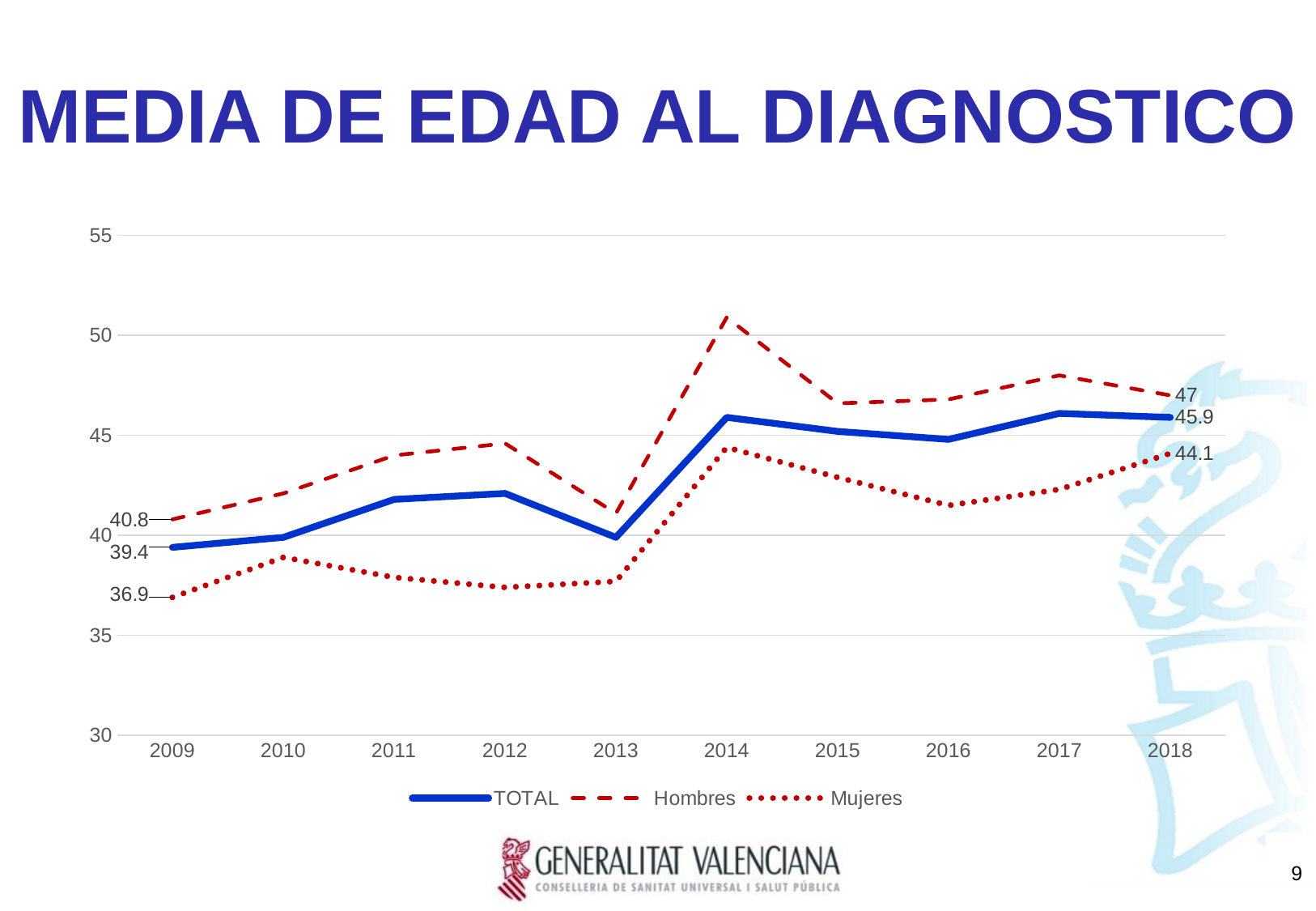
Which series has the higher value in 2009, TOTAL or Mujeres? TOTAL In which year does the Hombres series reach its highest value? 2014 What is the difference between the Hombres and Mujeres values in 2018? 2.9 What is the value for TOTAL in 2018? 45.9 What kind of chart is shown on the slide? Line chart What is the value for Mujeres in 2018? 44.1 Is the value for Hombres in 2014 greater or less than 50? greater What is the value for Hombres in 2009? 40.8 What is the difference between the Hombres value in 2018 and the Hombres value in 2009? 6.2 How many years are shown on the x axis? 10 What is the value for Mujeres in 2009? 36.9 How many series does the legend list? 3